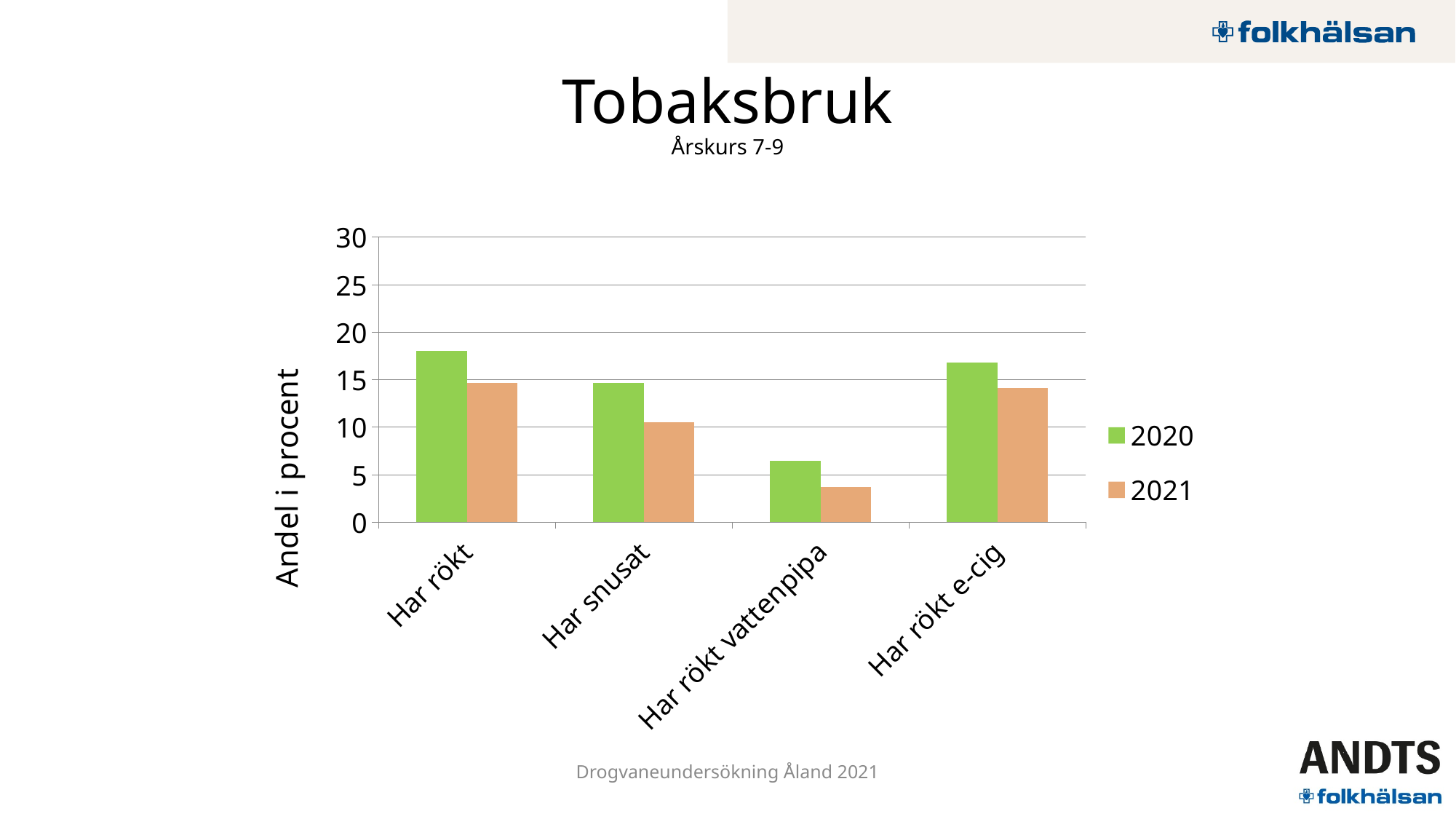
Is the 2020 value for Har rökt vattenpipa greater or less than 10? less What is the label on the vertical axis of the chart? Andel i procent How many categories are shown on the x axis of the chart? 4 For Har snusat, which series has the larger value, 2020 or 2021? 2020 Is the 2020 value for Har rökt e-cig greater or less than 15? greater What kind of chart is shown on the slide? bar chart How many series does the chart's legend list? 2 Which category has the lowest value for the 2020 series? Har rökt vattenpipa Which category has the lowest value for the 2021 series? Har rökt vattenpipa Is the 2020 value for Har rökt greater or less than 15? greater For Har rökt e-cig, which series has the larger value, 2020 or 2021? 2020